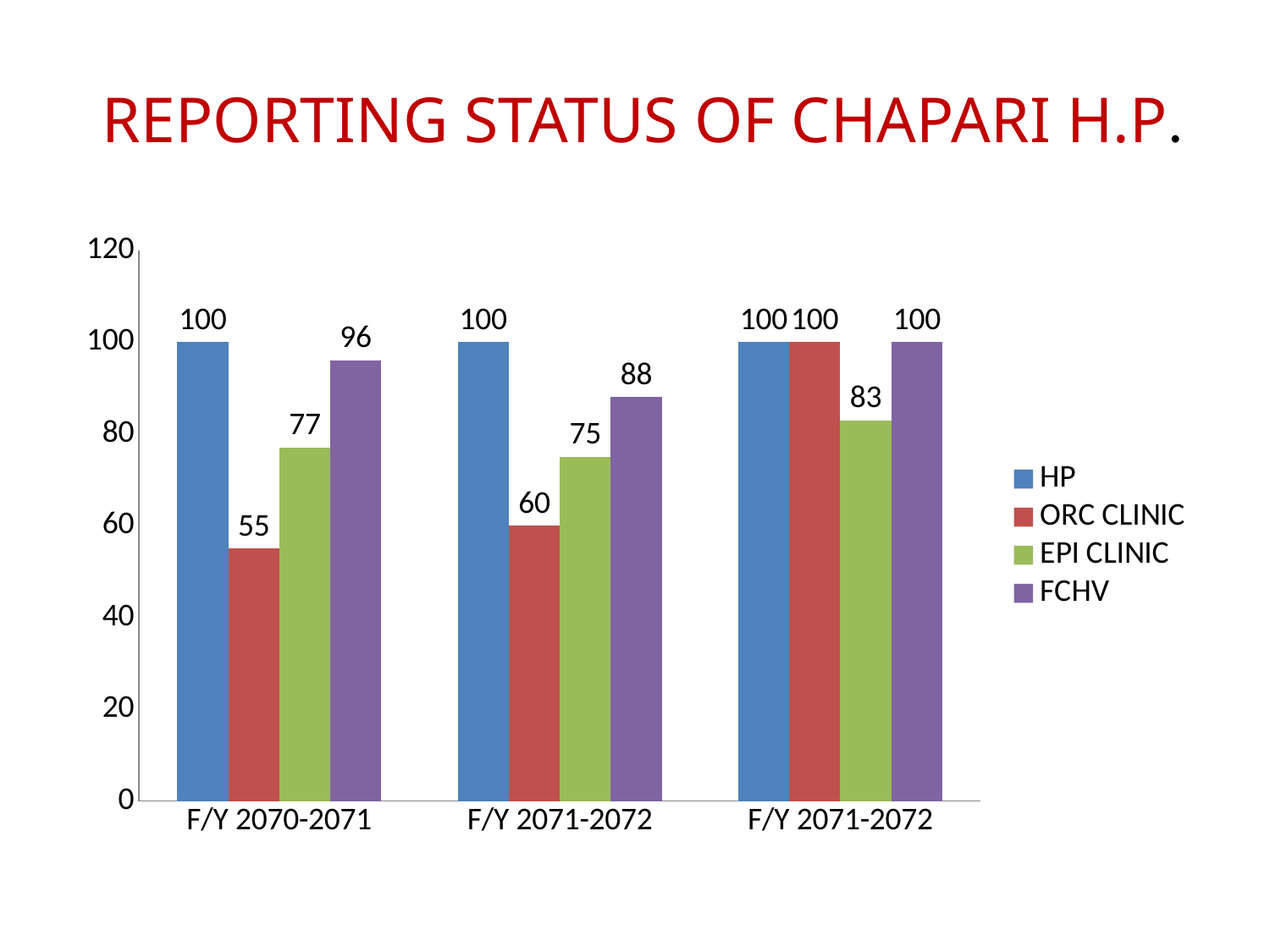
Which series has the lowest value in F/Y 2070-2071? ORC CLINIC How many series does the legend list? 4 What is the value for EPI CLINIC in the rightmost group? 83 What is the title of the chart? REPORTING STATUS OF CHAPARI H.P. How many category groups are shown along the x axis? 3 What is the value for EPI CLINIC in the middle group (F/Y 2071-2072)? 75 What is the difference between the HP and ORC CLINIC values in F/Y 2070-2071? 45 Does the ORC CLINIC value rise or fall from the first group to the rightmost group? rise What type of chart is shown on the slide? bar chart What is the value for ORC CLINIC in F/Y 2070-2071? 55 In the middle group (F/Y 2071-2072), which is larger: the FCHV value or the EPI CLINIC value? FCHV What is the value for FCHV in F/Y 2070-2071? 96